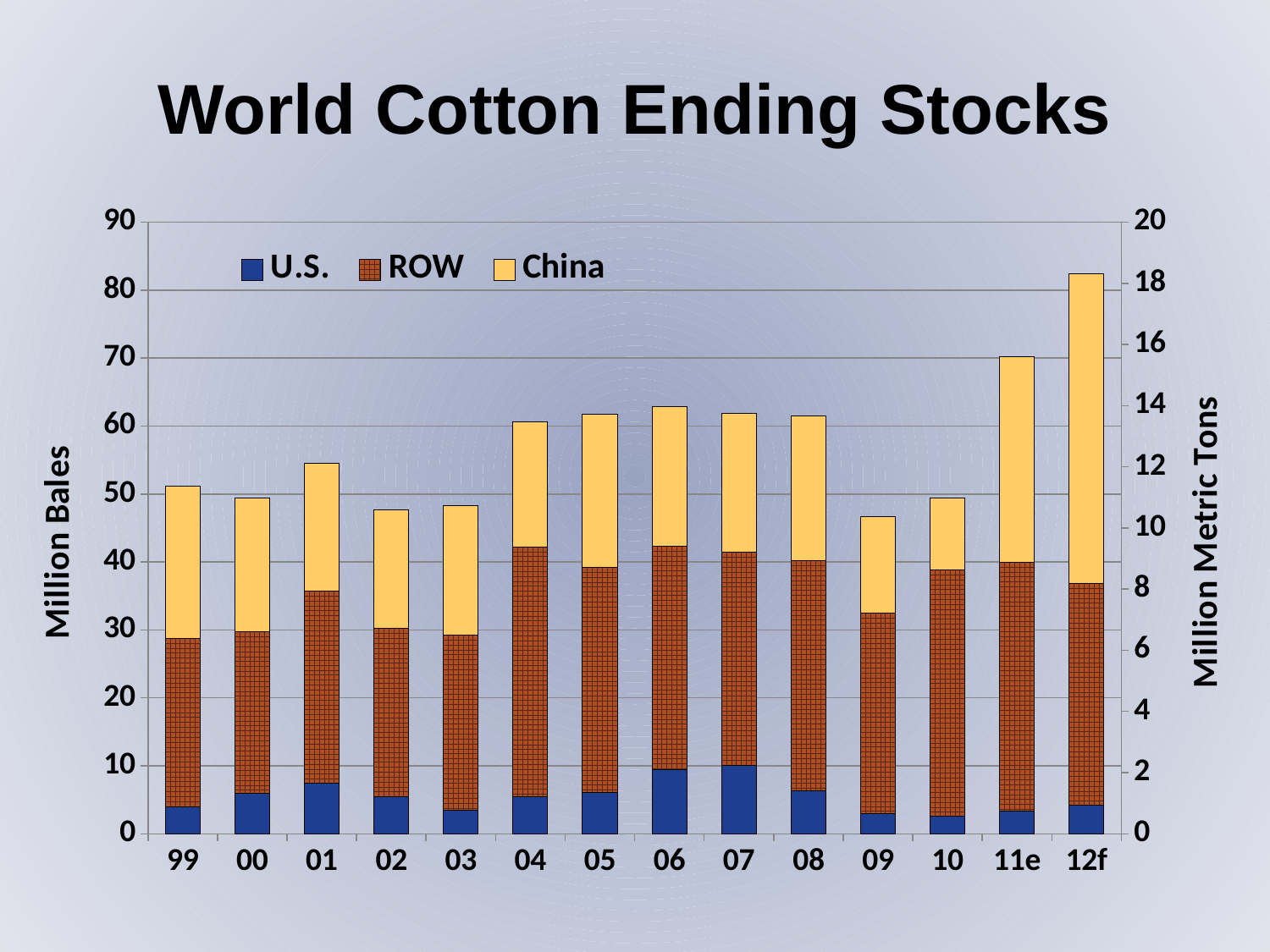
Is the total bar for 12f greater or less than 80 million bales? greater What is the label on the left vertical axis? Million Bales How many series does the legend list? 3 Which has the larger total ending stocks, 11e or 12f? 12f Which year has the highest total ending stocks? 12f Is the total bar for 09 greater or less than 50 million bales? less Is the total bar for 11e greater or less than 60 million bales? greater How many years (categories) are shown on the x axis? 14 What kind of chart is shown on the slide? stacked bar chart Do total ending stocks rise or fall from 09 to 12f? rise Which has the larger total ending stocks, 03 or 04? 04